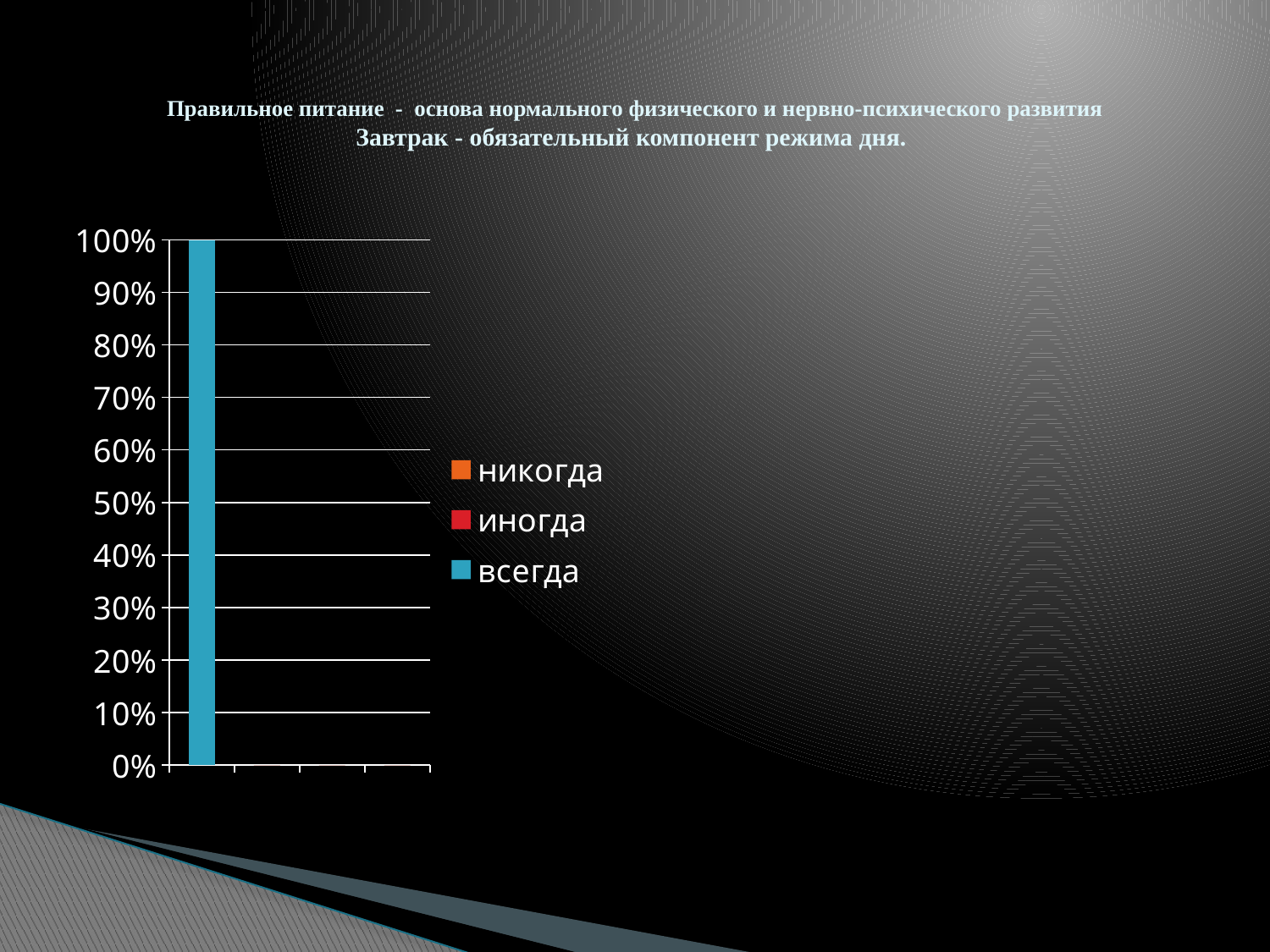
What are the series names listed in the legend? никогда, иногда, всегда Is the value of the visible bar greater or less than 90%? greater What kind of chart is shown on the slide? bar chart What is the lowest value shown on the vertical axis? 0% How many bars are visible in the chart? 1 What value does the visible bar reach on the vertical axis? 100% How many series does the legend list? 3 Which legend series does the single visible bar belong to? всегда Is the value of the visible bar greater or less than 50%? greater What is the highest value shown on the vertical axis? 100%